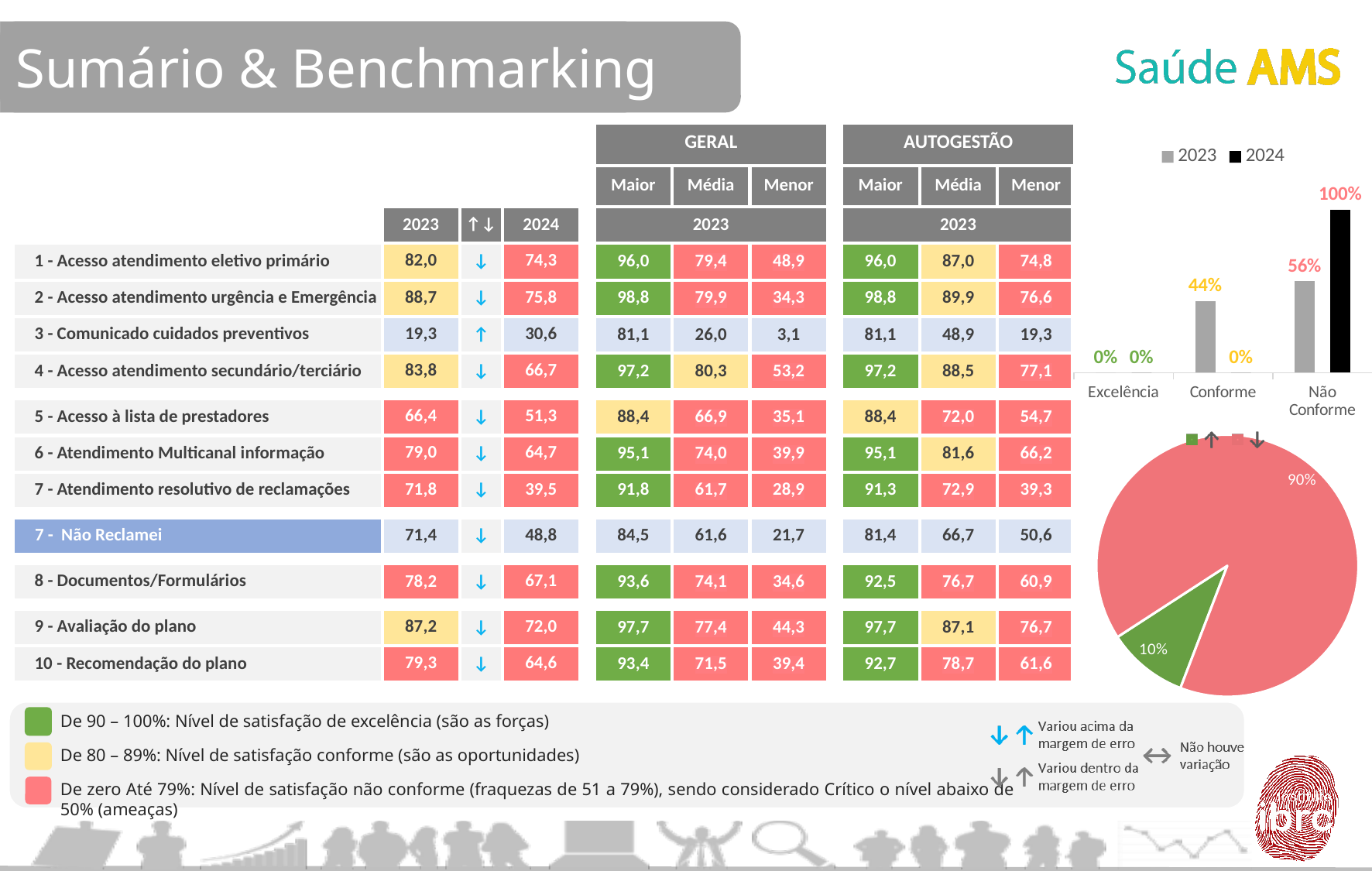
In the pie chart at the bottom right, what share does the largest slice represent? 90% In the bar chart at the top right, what is the difference between the 2024 and 2023 values for Não Conforme? 44% In the bar chart at the top right, what is the 2024 value for Conforme? 0% In the bar chart at the top right, how many series does the legend list? 2 In the pie chart at the bottom right, what share does the green slice represent? 10% In the bar chart at the top right, what is the 2024 value for Não Conforme? 100% In the bar chart at the top right, what is the 2023 value for Não Conforme? 56% In the bar chart at the top right, which is larger for Não Conforme: the 2023 value or the 2024 value? 2024 What type of chart is shown at the top right of the slide? Bar chart In the bar chart at the top right, what is the 2023 value for Conforme? 44% In the bar chart at the top right, how many categories are shown on the x axis? 3 In the bar chart at the top right, which category has the highest 2024 value? Não Conforme